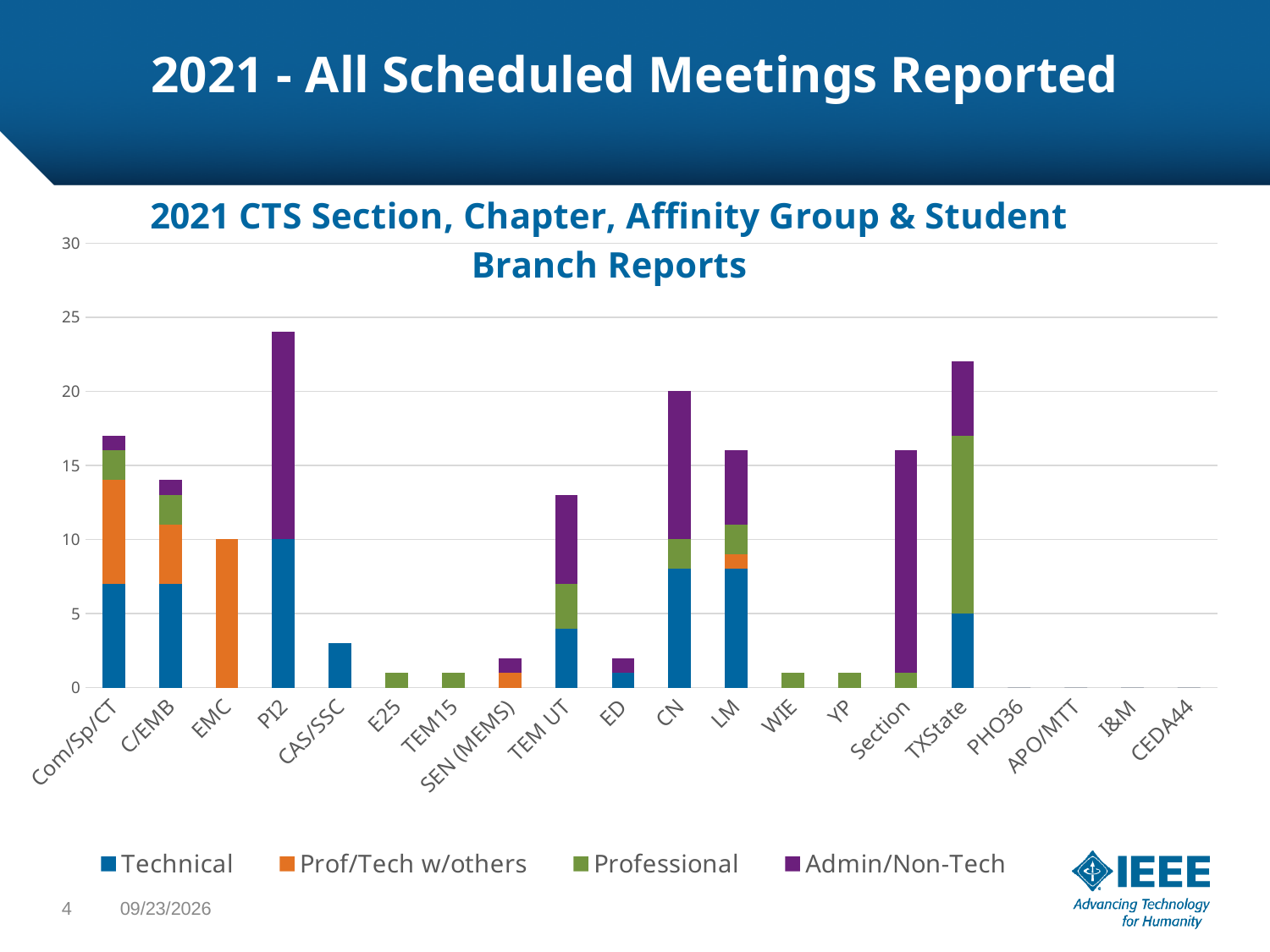
Is the total value for EMC greater or less than 15? less How many series does the legend list? 4 Is the total value for Section greater or less than 10? greater Which category has the tallest stacked bar overall? PI2 What is the title of the chart? 2021 CTS Section, Chapter, Affinity Group & Student Branch Reports Which has the taller stacked bar, Com/Sp/CT or C/EMB? Com/Sp/CT Is the total value for CAS/SSC greater or less than 5? less Which has the taller stacked bar, PI2 or CN? PI2 How many categories are shown along the x axis? 20 Which colour represents the Admin/Non-Tech series in the legend? Purple What kind of chart is shown on the slide? Stacked bar chart